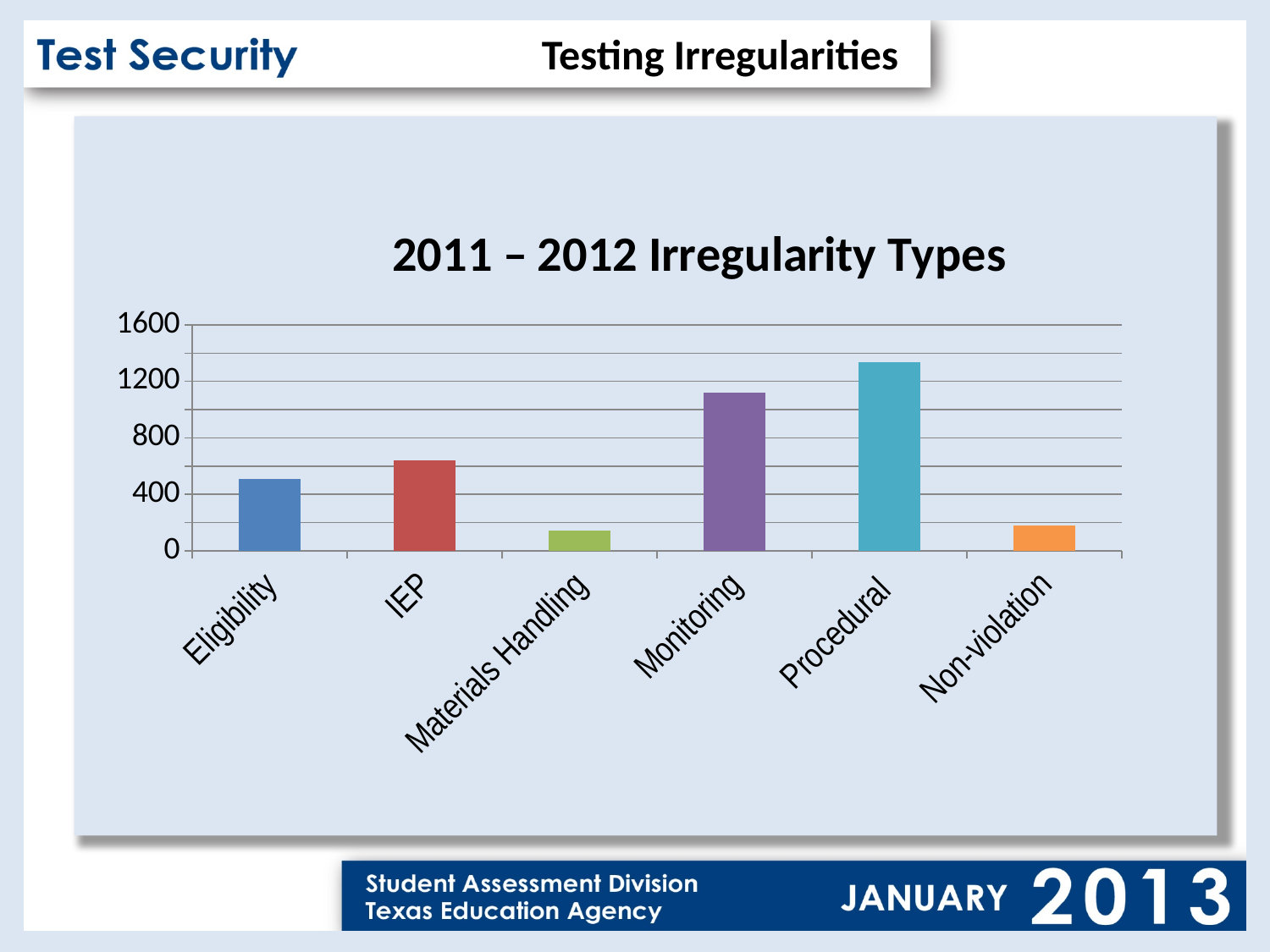
Is the value for Materials Handling greater or less than 400? less Is the value for Monitoring greater or less than 1200? less Which is larger, the value for Eligibility or the value for IEP? IEP Is the value for Monitoring greater or less than 800? greater How many irregularity type categories are shown on the x axis? 6 What kind of chart is shown on the slide? bar chart What is the title of the chart? 2011 – 2012 Irregularity Types Which is larger, the value for Monitoring or the value for Procedural? Procedural Which irregularity type has the highest value? Procedural